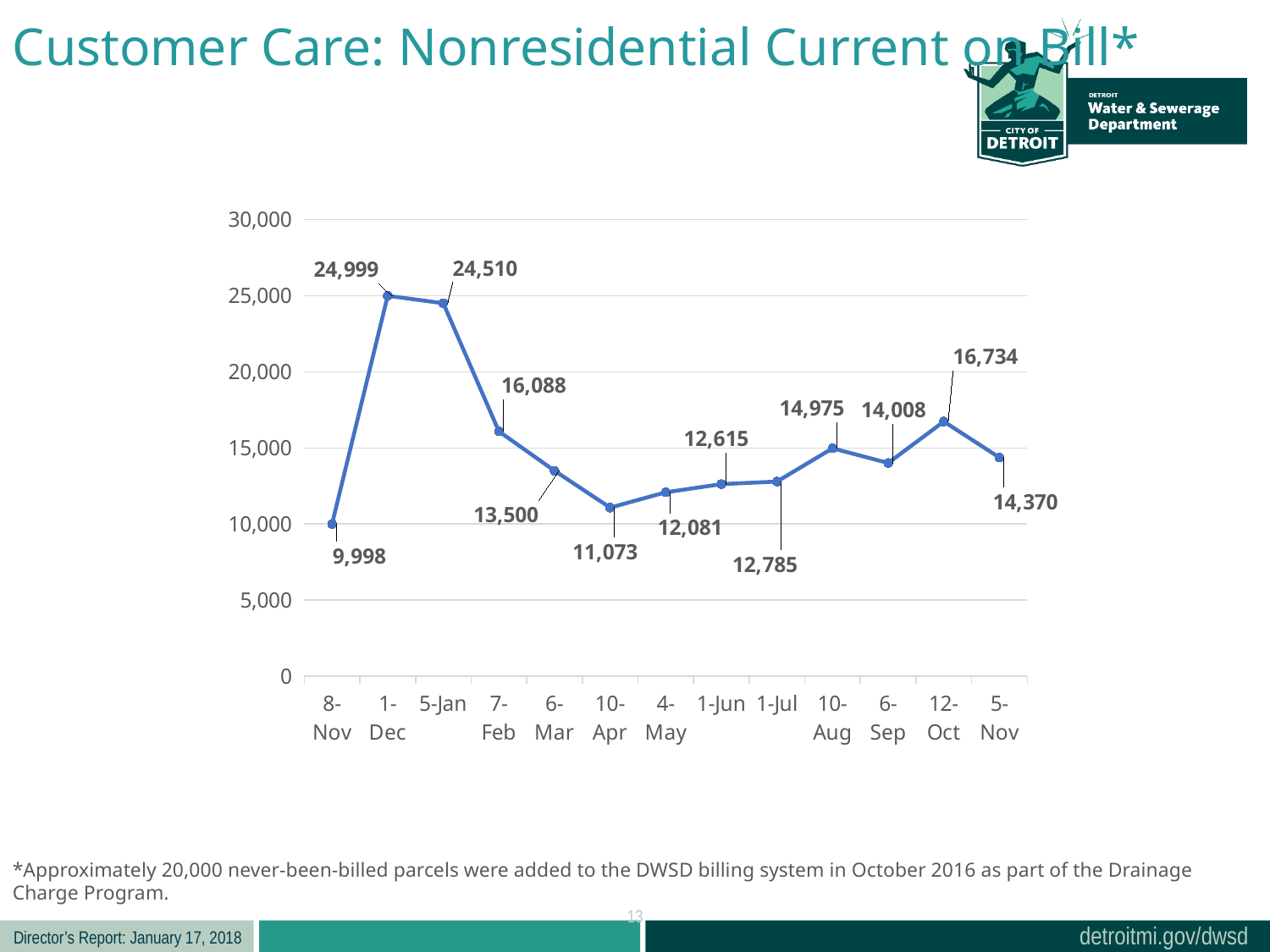
Do the values rise or fall from 5-Jan to 10-Apr? fall Which date has the highest value? 1-Dec What is the value for 12-Oct? 16,734 What is the value for 10-Apr? 11,073 What kind of chart is shown on the slide? line chart Is the value for 7-Feb greater or less than 15,000? greater How many data points are plotted on the chart? 13 What is the value for 1-Dec? 24,999 Which date has the lowest value? 8-Nov What is the difference between the values for 1-Dec and 5-Jan? 489 Which is larger, the value for 10-Aug or the value for 6-Sep? 10-Aug What is the difference between the values for 12-Oct and 5-Nov? 2,364